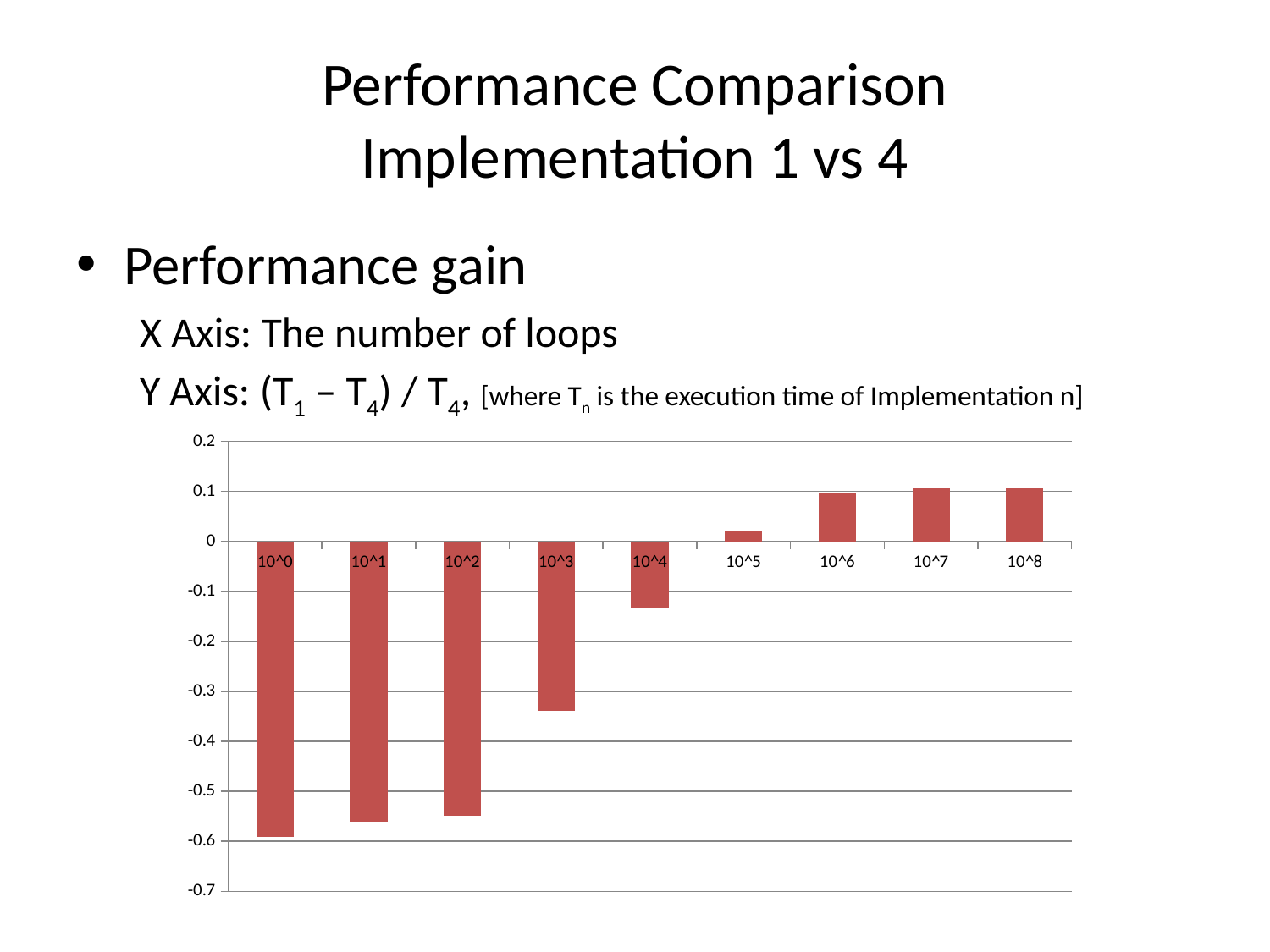
Which is larger, the value for 10^2 or the value for 10^6? 10^6 Which is larger, the value for 10^3 or the value for 10^4? 10^4 Is the value for 10^5 greater or less than 0.1? less Is the value for 10^0 greater or less than -0.5? less Is the value for 10^3 greater or less than -0.3? less Do the values generally rise or fall as the number of loops increases along the x axis? rise What is the title of the slide containing the chart? Performance Comparison Implementation 1 vs 4 How many categories are plotted along the x axis? 9 How many categories have a negative value? 5 What kind of chart is shown on the slide? bar chart